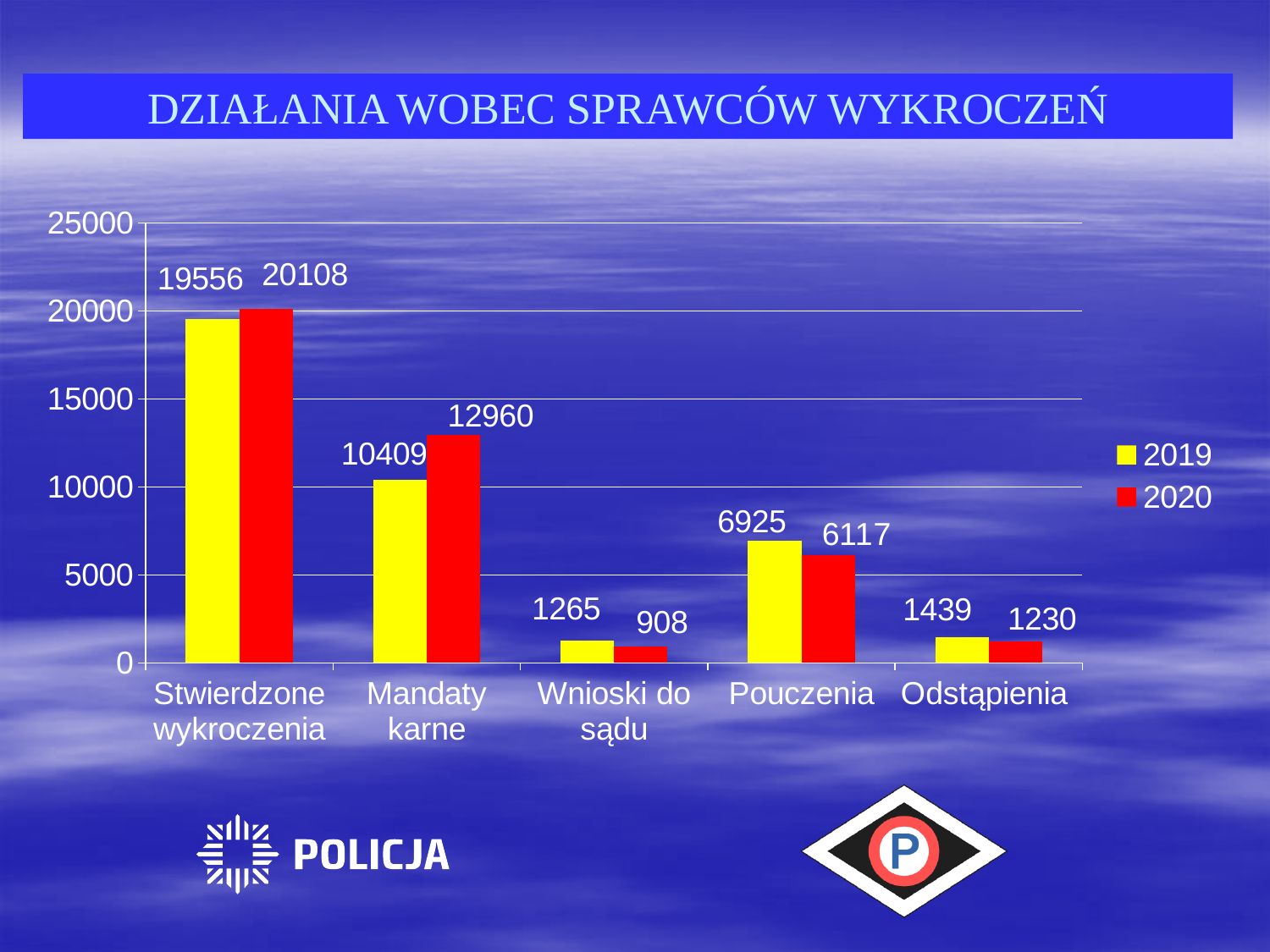
Which category has the highest 2019 value? Stwierdzone wykroczenia Which is larger for Pouczenia: the 2019 value or the 2020 value? 2019 Is the 2020 value for Mandaty karne greater or less than 10000? greater What is the 2019 value for Pouczenia? 6925 How many series does the legend list? 2 How many categories are shown on the x axis? 5 What is the difference between the 2020 and 2019 values for Stwierdzone wykroczenia? 552 What is the 2020 value for Wnioski do sądu? 908 What is the 2020 value for Mandaty karne? 12960 What is the difference between the 2019 and 2020 values for Odstąpienia? 209 Which category has the lowest 2020 value? Wnioski do sądu What type of chart is shown on the slide? bar chart